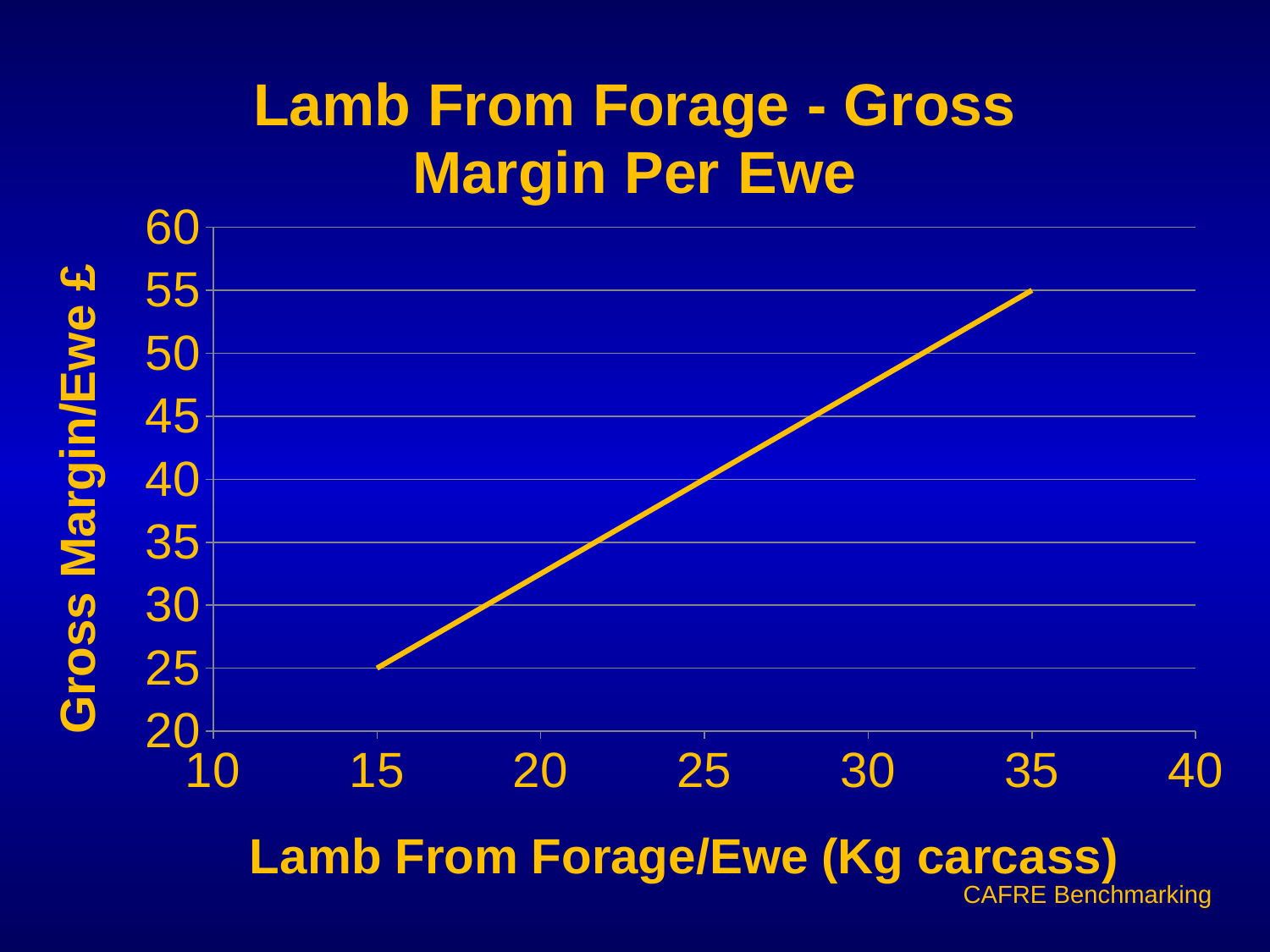
Does the gross margin per ewe rise or fall as lamb from forage per ewe increases? rise Is the gross margin per ewe at 20 kg lamb from forage greater or less than 30? greater What is the gross margin per ewe when lamb from forage per ewe is 35 kg carcass? 55 What kind of chart is shown on the slide? line chart Is the gross margin per ewe at 30 kg lamb from forage greater or less than 50? less Which gives a higher gross margin per ewe: 15 kg or 35 kg of lamb from forage per ewe? 35 kg What is the gross margin per ewe when lamb from forage per ewe is 15 kg carcass? 25 What is the difference in gross margin per ewe between 35 kg and 15 kg of lamb from forage per ewe? 30 At which lamb from forage per ewe value shown does the line reach its highest gross margin? 35 What is the title of the chart? Lamb From Forage - Gross Margin Per Ewe What is the gross margin per ewe when lamb from forage per ewe is 25 kg carcass? 40 What is the label on the x axis of the chart? Lamb From Forage/Ewe (Kg carcass)